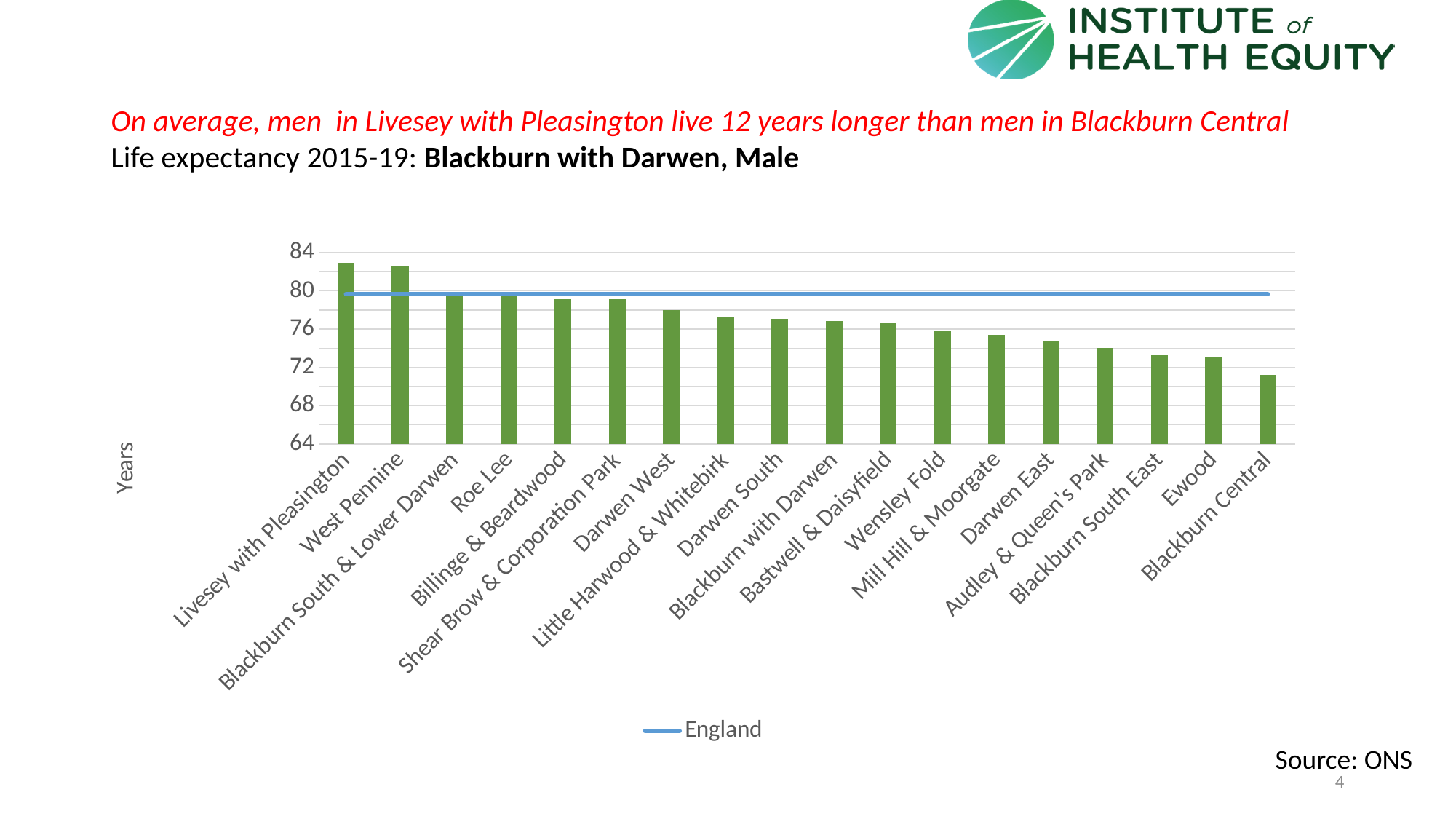
Which ward has the lowest male life expectancy in the chart? Blackburn Central Is the value for Darwen West greater or less than 80? less Is the value for Blackburn Central greater or less than 72? less Is the value for Livesey with Pleasington greater or less than 80? greater Which ward has the highest male life expectancy in the chart? Livesey with Pleasington What kind of chart is shown on the slide? bar chart How many wards (bars) are plotted in the chart? 18 Which has the higher value, West Pennine or Ewood? West Pennine What is the label on the vertical axis of the chart? Years Do the bar values rise or fall moving from left to right along the x axis? fall What entry does the chart legend list? England